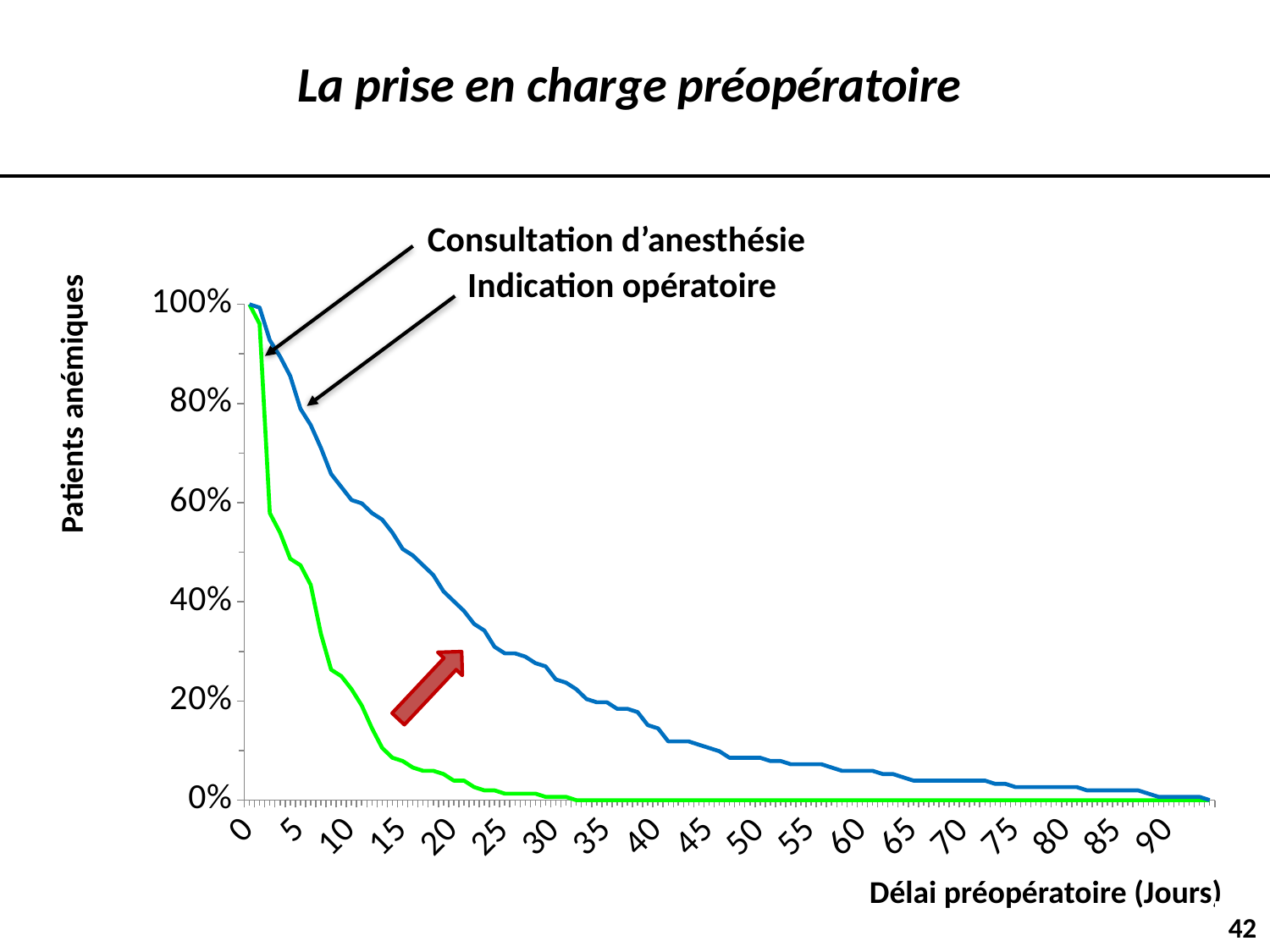
Do the values of the Indication opératoire line rise or fall as the preoperative delay increases? fall At a delay of 20 days, which series has the lower value, Indication opératoire or Consultation d'anesthésie? Consultation d'anesthésie At a delay of 50 days, is the value for Indication opératoire greater or less than 20%? less How many series (lines) are plotted on the chart? 2 At a delay of 30 days, is the value for Indication opératoire greater or less than 40%? less At a delay of 15 days, is the value for Consultation d'anesthésie greater or less than 20%? less What is the title of the x axis? Délai préopératoire (Jours) What is the title of the y axis? Patients anémiques At a delay of 10 days, which series has the higher value, Indication opératoire or Consultation d'anesthésie? Indication opératoire What kind of chart is shown on the slide? line chart Which series is drawn in green? Consultation d'anesthésie Do the values of the Consultation d'anesthésie line rise or fall along the x axis? fall